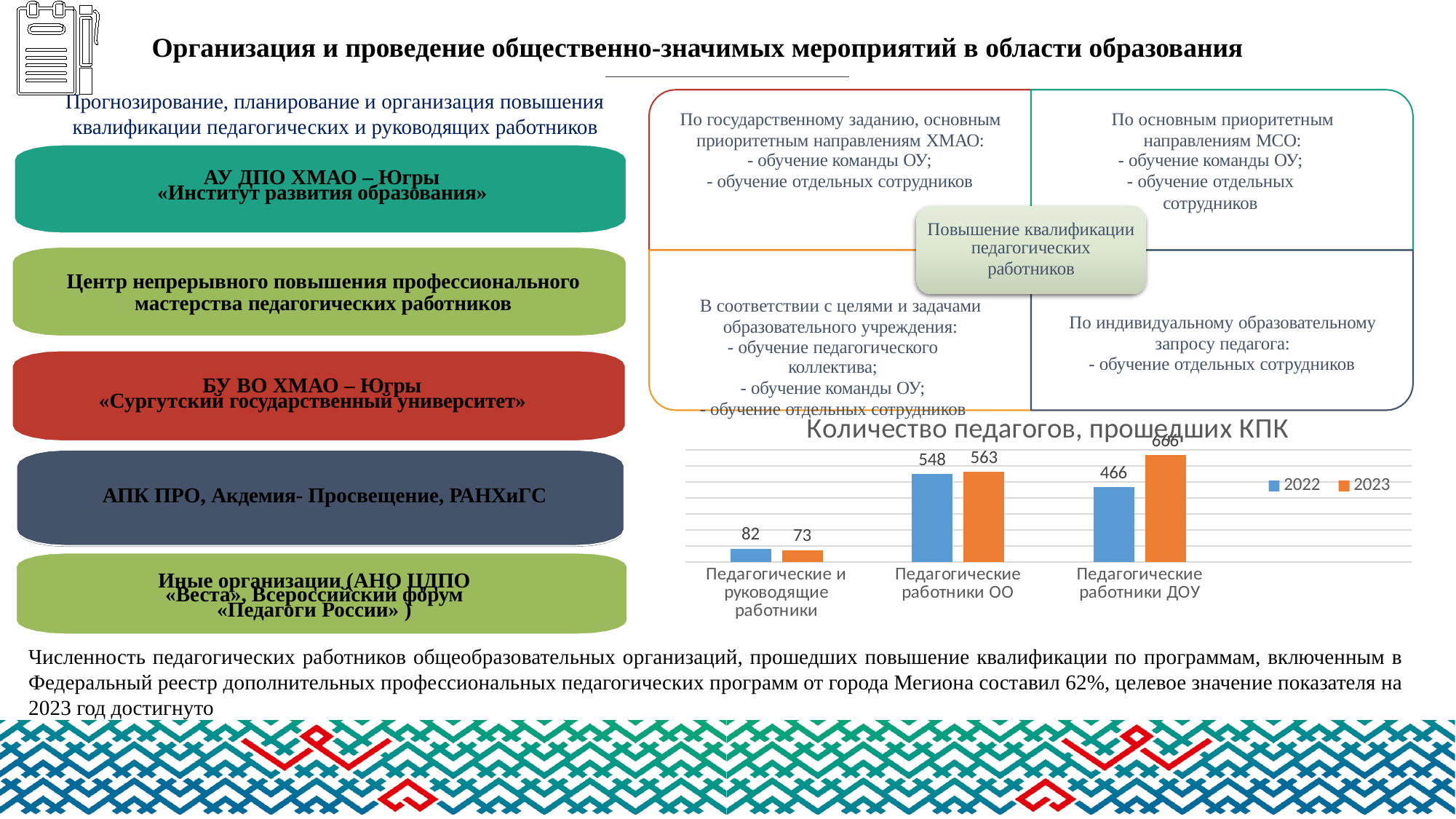
What type of chart is "Количество педагогов, прошедших КПК"? bar chart In the chart "Количество педагогов, прошедших КПК", which series is shown in orange? 2023 In the chart "Количество педагогов, прошедших КПК", which category has the lowest 2022 value? Педагогические и руководящие работники In the chart "Количество педагогов, прошедших КПК", what is the 2023 value for "Педагогические и руководящие работники"? 73 How many categories are shown on the x axis of the chart "Количество педагогов, прошедших КПК"? 3 In the chart "Количество педагогов, прошедших КПК", which is larger for "Педагогические работники ДОУ": the 2022 value or the 2023 value? 2023 In the chart "Количество педагогов, прошедших КПК", what is the 2022 value for "Педагогические и руководящие работники"? 82 In the chart "Количество педагогов, прошедших КПК", what is the 2023 value for "Педагогические работники ОО"? 563 In the chart "Количество педагогов, прошедших КПК", what is the 2022 value for "Педагогические работники ОО"? 548 How many series does the legend of the chart "Количество педагогов, прошедших КПК" list? 2 In the chart "Количество педагогов, прошедших КПК", what is the difference between the 2023 and 2022 values for "Педагогические работники ОО"? 15 In the chart "Количество педагогов, прошедших КПК", what is the 2022 value for "Педагогические работники ДОУ"? 466